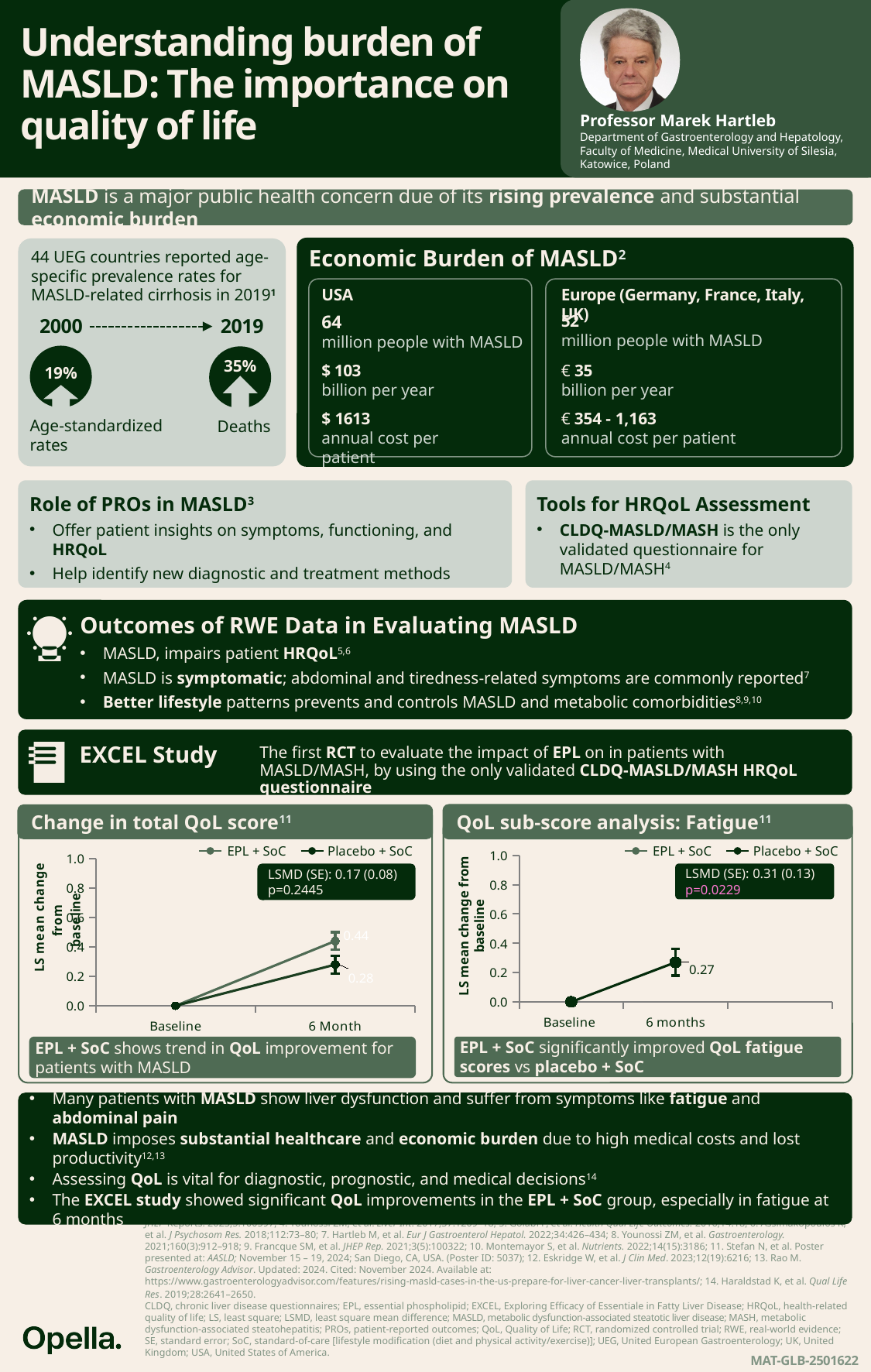
In the 'Change in total QoL score' chart, what is the LS mean change from baseline for Placebo + SoC at 6 Month? 0.28 In the 'QoL sub-score analysis: Fatigue' chart, what LSMD (SE) is reported? 0.31 (0.13) In the 'Change in total QoL score' chart, what p-value is shown? p=0.2445 In the 'Change in total QoL score' chart, how many series does the legend list? 2 In the 'Change in total QoL score' chart, is the value for EPL + SoC at 6 Month greater or less than 0.4? greater What kind of chart is the 'Change in total QoL score' chart? Line chart In the 'QoL sub-score analysis: Fatigue' chart, what value is labelled at 6 months? 0.27 In the 'QoL sub-score analysis: Fatigue' chart, how many time points are shown on the x axis? 2 In the 'Change in total QoL score' chart, what is the difference between the EPL + SoC and Placebo + SoC values at 6 Month? 0.16 In the 'Change in total QoL score' chart, what is the LS mean change from baseline for EPL + SoC at 6 Month? 0.44 In the 'Change in total QoL score' chart, do the values rise or fall from Baseline to 6 Month? Rise In the 'Change in total QoL score' chart, which series has the higher value at 6 Month? EPL + SoC